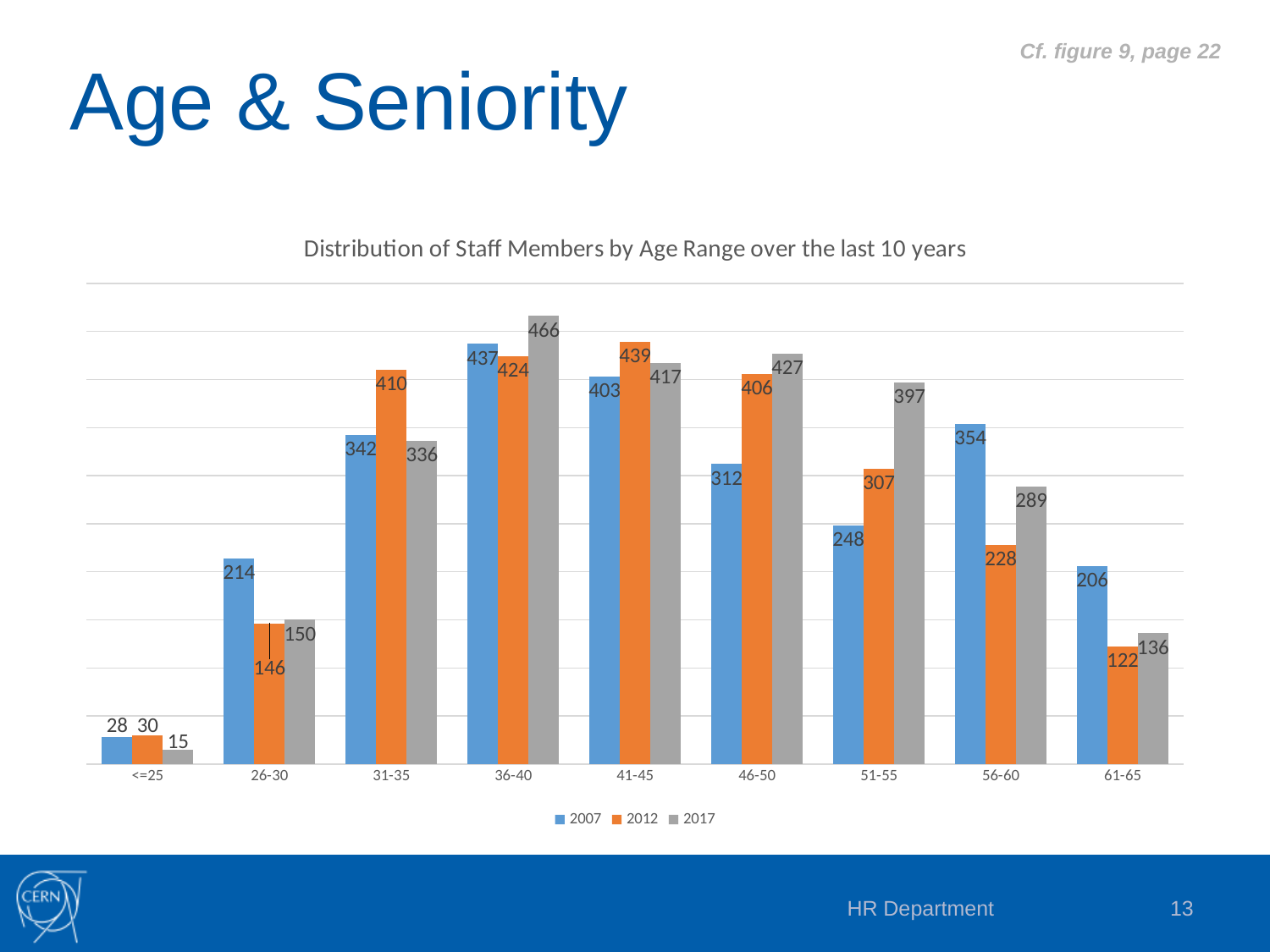
What is the difference between the 2017 and 2007 values for the 56-60 age range? 65 Which year does the orange series represent? 2012 Which age range has the lowest value in the 2007 series? <=25 What is the value for the 26-30 age range in 2012? 146 What is the value for the 51-55 age range in 2007? 248 How many age ranges are shown on the x axis? 9 What is the title of the chart? Distribution of Staff Members by Age Range over the last 10 years Which age range has the highest value in the 2017 series? 36-40 What kind of chart is shown on the slide? bar chart What is the value for the 36-40 age range in 2017? 466 How many series does the legend list? 3 Which is larger for the 31-35 age range: the 2012 value or the 2017 value? 2012